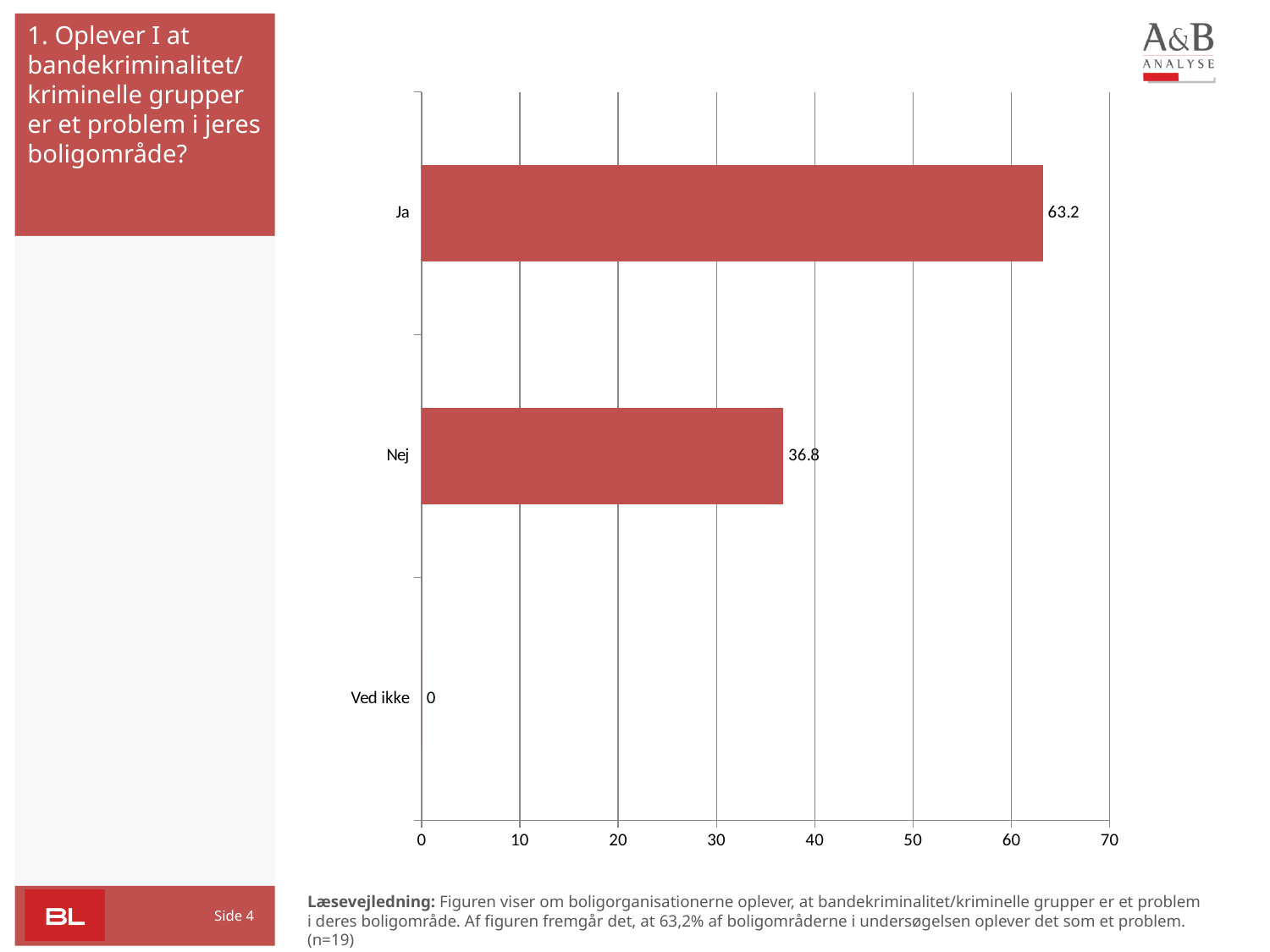
What is the highest value shown on the x axis? 70 How many categories are shown on the chart? 3 Which category has the highest value? Ja Which category has the lowest value? Ved ikke What is the value for Ja? 63.2 Which is larger, the value for Ja or the value for Nej? Ja Is the value for Ja greater or less than 60? greater Is the value for Nej greater or less than 40? less What is the difference between the values for Ja and Nej? 26.4 What is the value for Nej? 36.8 What kind of chart is shown on the slide? bar chart What is the value for Ved ikke? 0